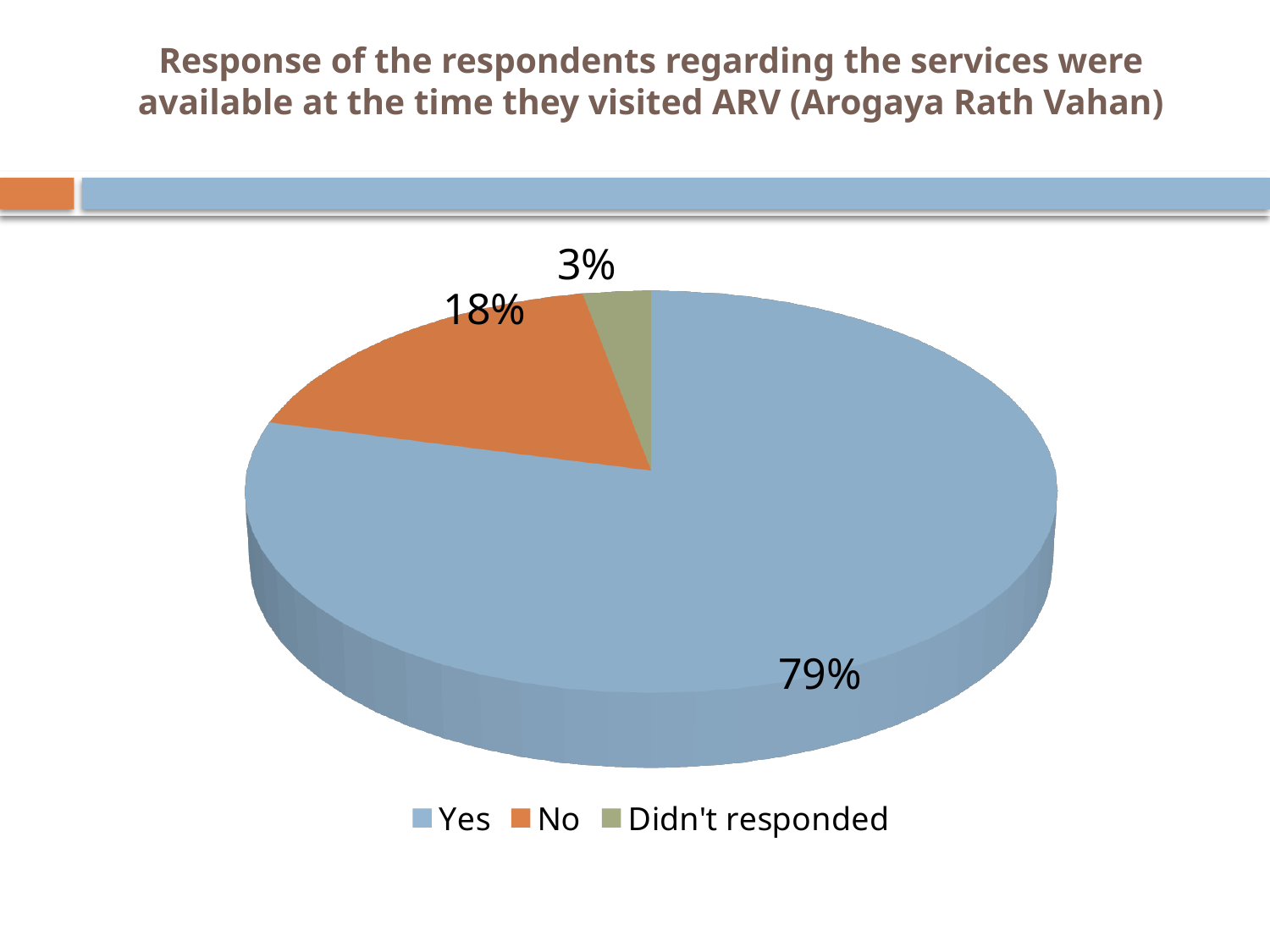
Which is larger, the share for No or the share for Didn't responded? No Which colour represents the No category in the legend? Orange What percentage of respondents didn't respond? 3% Which response category has the largest share of the pie? Yes What is the difference in percentage points between the No share and the Didn't responded share? 15 What kind of chart is shown on the slide? Pie chart What percentage of respondents answered Yes? 79% How many categories does the pie chart show? 3 What percentage of respondents answered No? 18% What is the difference in percentage points between the Yes and No shares? 61 What share of the pie does the Yes slice represent? 79% Which response category has the smallest share of the pie? Didn't responded